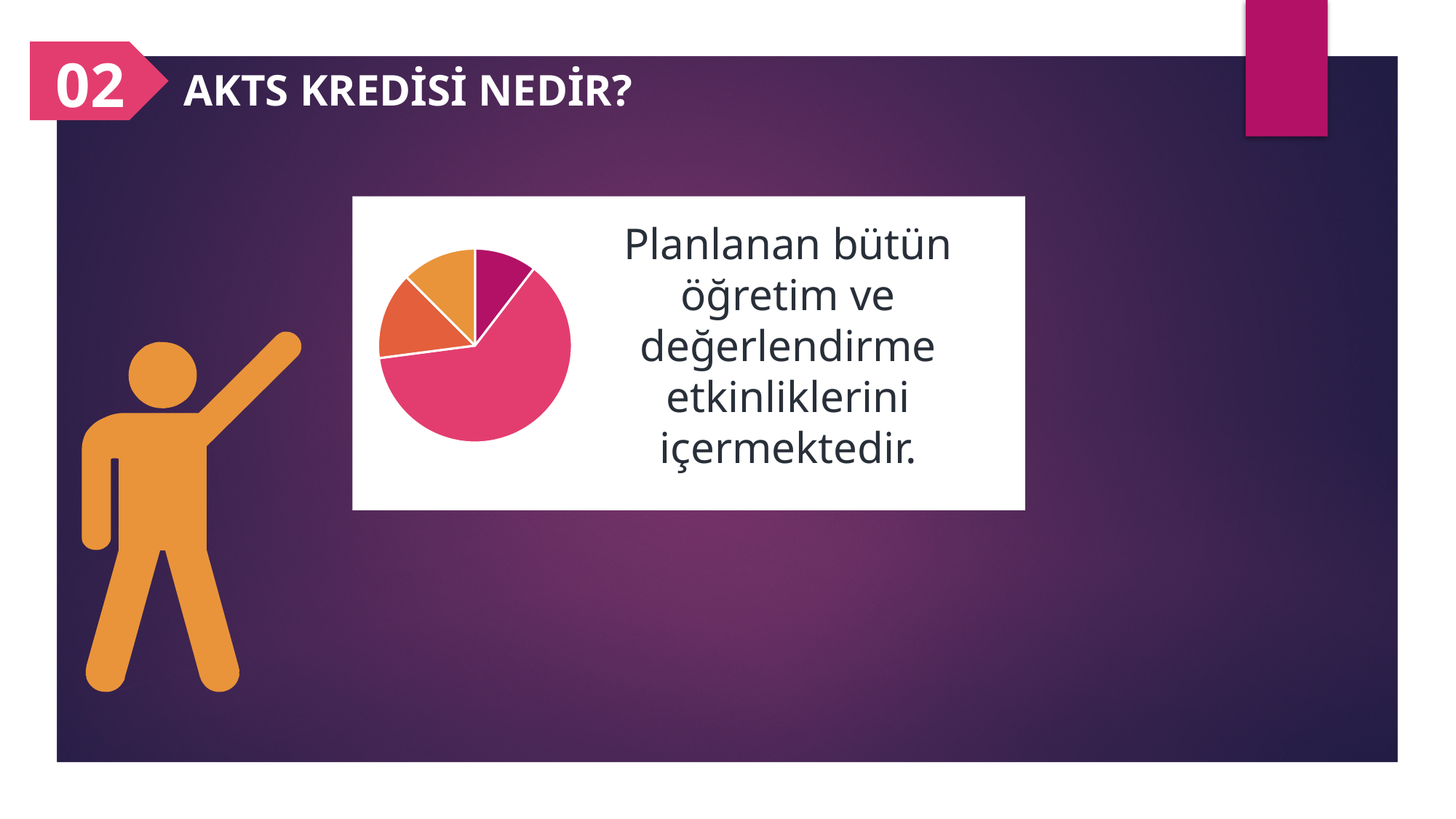
Does the pie chart show any data labels on its slices? No Is the pink slice of the pie chart greater or less than half of the pie? greater How many slices does the pie chart have? 4 Which colour slice is the largest in the pie chart? pink Does the pie chart display a legend? No What kind of chart is shown on the slide? pie chart